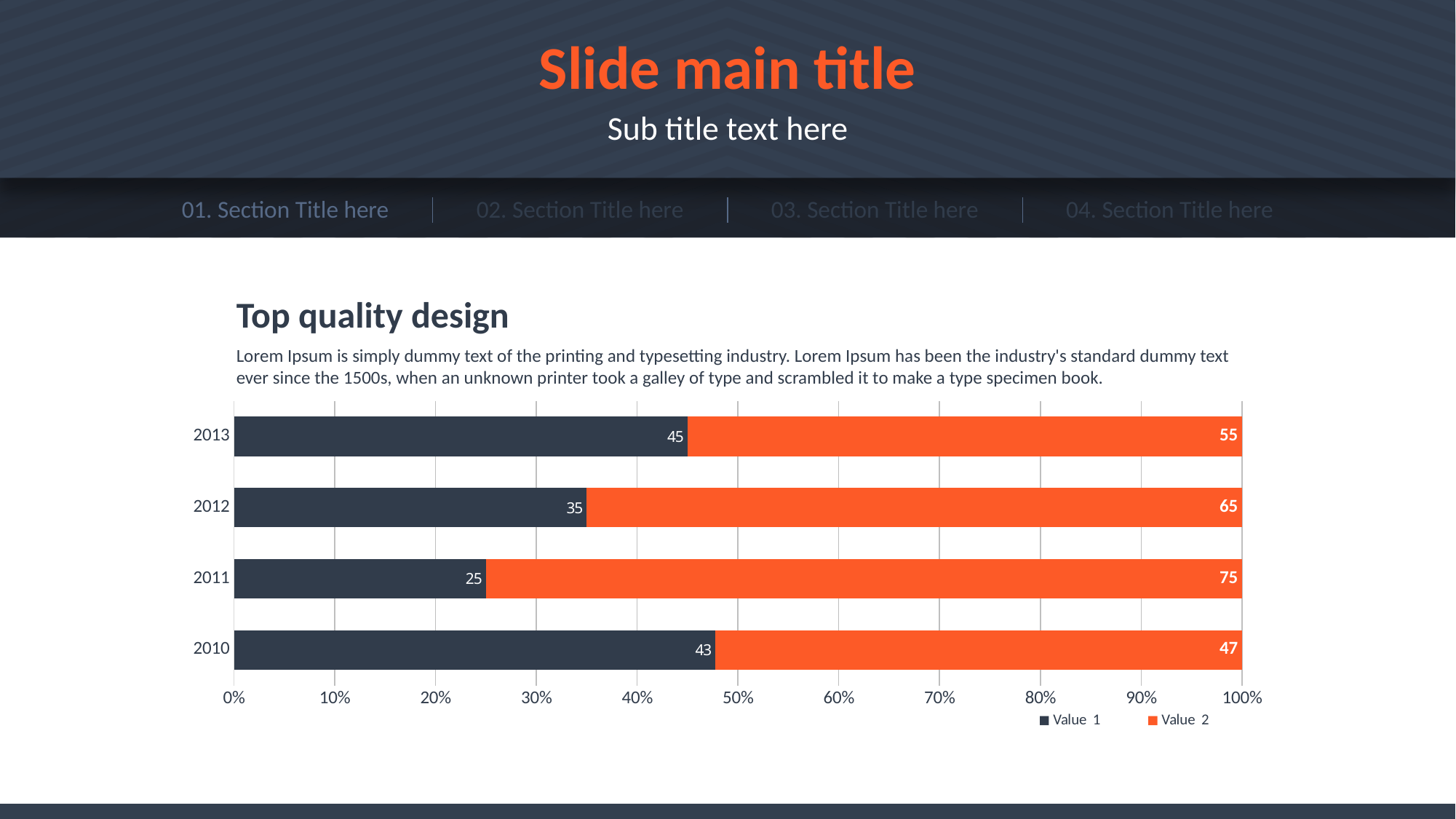
What kind of chart is shown on the slide? Stacked bar chart What is the difference between Value 2 and Value 1 for 2012? 30 What is the value of Value 1 for 2013? 45 What is the value of Value 1 for 2010? 43 How many series does the legend list? 2 What colour represents Value 2 in the chart? Orange How many years are shown on the chart? 4 What is the value of Value 2 for 2012? 65 Which is larger for 2010, Value 1 or Value 2? Value 2 Which year has the lowest Value 1? 2011 Which year has the highest Value 2? 2011 What is the value of Value 2 for 2011? 75